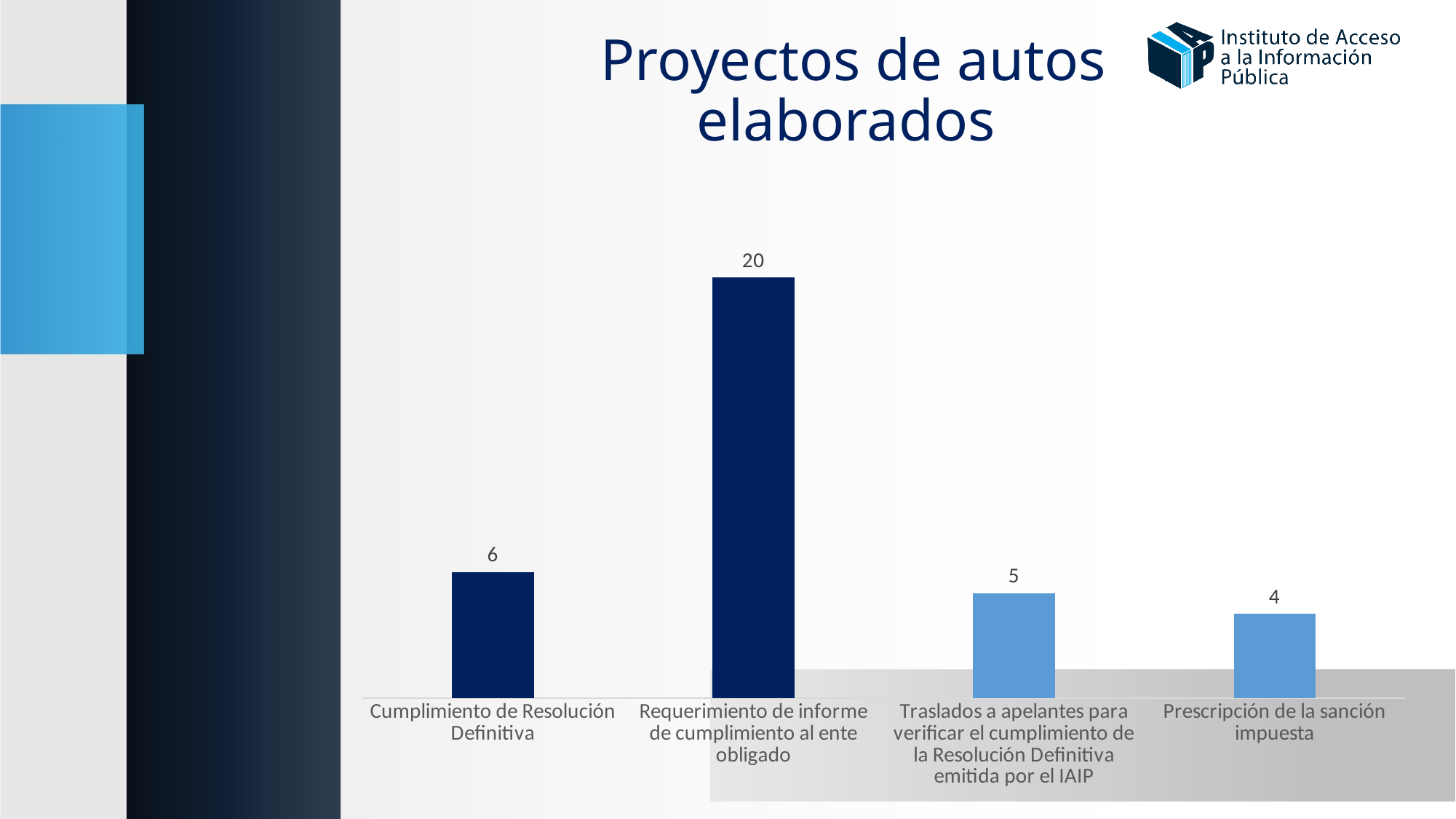
What is the title of the slide? Proyectos de autos elaborados What is the value for Prescripción de la sanción impuesta? 4 Which is larger: the value for Cumplimiento de Resolución Definitiva or the value for Traslados a apelantes para verificar el cumplimiento de la Resolución Definitiva emitida por el IAIP? Cumplimiento de Resolución Definitiva Which category has the highest value? Requerimiento de informe de cumplimiento al ente obligado What is the total of all four values shown in the chart? 35 What is the value for Traslados a apelantes para verificar el cumplimiento de la Resolución Definitiva emitida por el IAIP? 5 What kind of chart is shown on the slide? Bar chart What is the difference between the values for Requerimiento de informe de cumplimiento al ente obligado and Cumplimiento de Resolución Definitiva? 14 What is the value for Cumplimiento de Resolución Definitiva? 6 How many categories are shown in the chart? 4 What is the value for Requerimiento de informe de cumplimiento al ente obligado? 20 Which category has the lowest value? Prescripción de la sanción impuesta